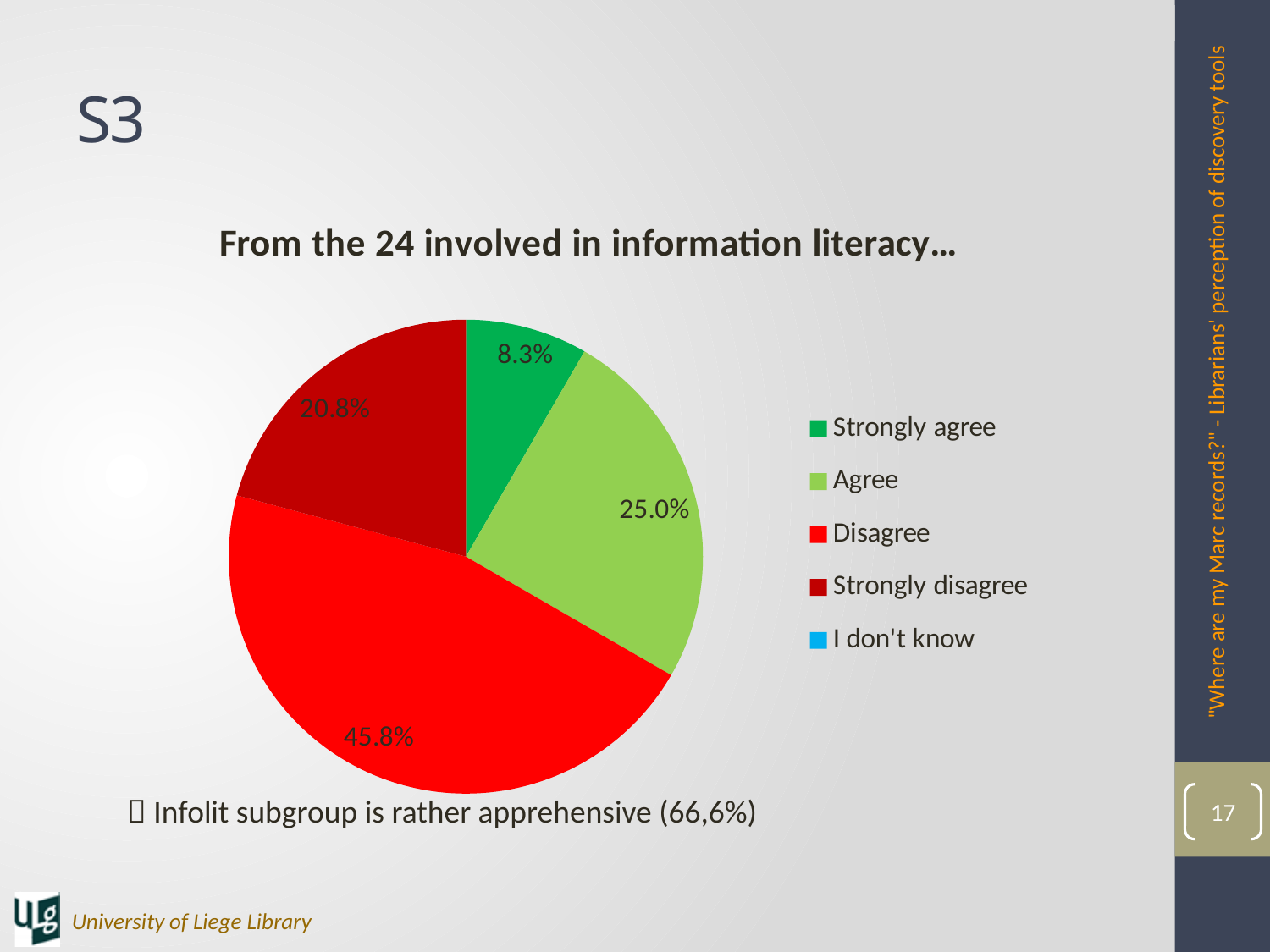
Which slice is larger, Agree or Strongly disagree? Agree What is the title of the chart? From the 24 involved in information literacy… What percentage of the pie is the Strongly disagree slice? 20.8% What percentage of the pie is the Strongly agree slice? 8.3% What percentage of the pie is the Disagree slice? 45.8% Which legend entry is shown in light blue? I don't know Which labelled slice of the pie is the smallest? Strongly agree How many entries does the chart's legend list? 5 What is the difference in percentage points between the Disagree and Agree slices? 20.8 What percentage of the pie is the Agree slice? 25.0% Which category has the largest slice of the pie? Disagree What kind of chart is shown on the slide? Pie chart